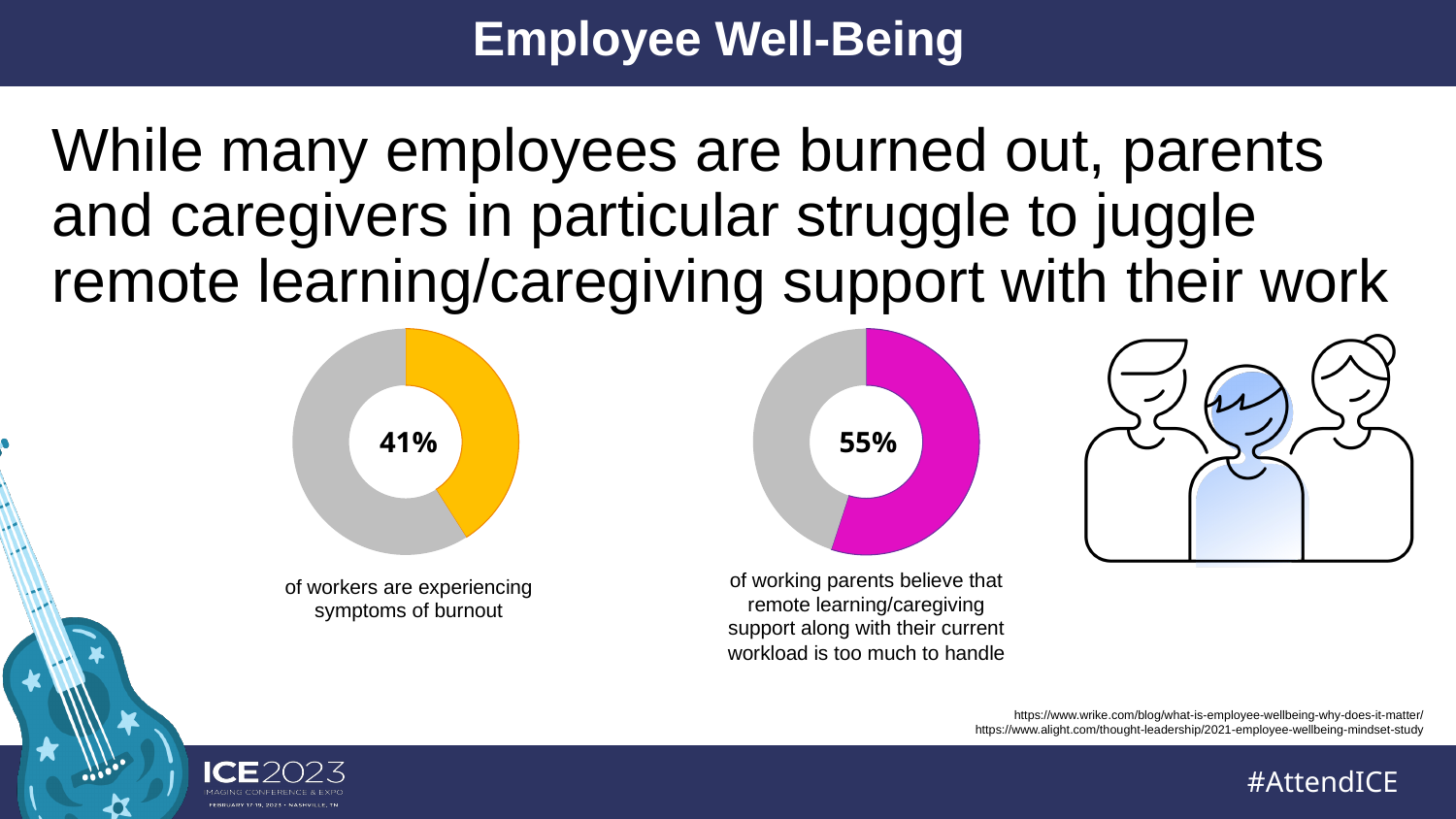
Which is larger: the percentage of workers experiencing burnout symptoms (left chart) or the percentage of working parents who find their workload too much to handle (right chart)? Working parents who find their workload too much to handle (55%) On the right donut chart, what percentage of working parents believe that remote learning/caregiving support along with their current workload is too much to handle? 55% What colour is the highlighted slice on the right donut chart? Magenta (pink) What colour is the highlighted slice on the left donut chart? Yellow What is the difference in percentage points between the value on the right donut chart and the value on the left donut chart? 14 percentage points How many donut charts are shown on the slide? 2 Is the value shown on the right donut chart greater or less than 50%? greater What kind of chart is used to show the 55% figure on the right? Donut (pie) chart On the left donut chart, what percentage of workers are experiencing symptoms of burnout? 41% Is the value shown on the left donut chart greater or less than 50%? less What kind of chart is used to show the 41% figure on the left? Donut (pie) chart